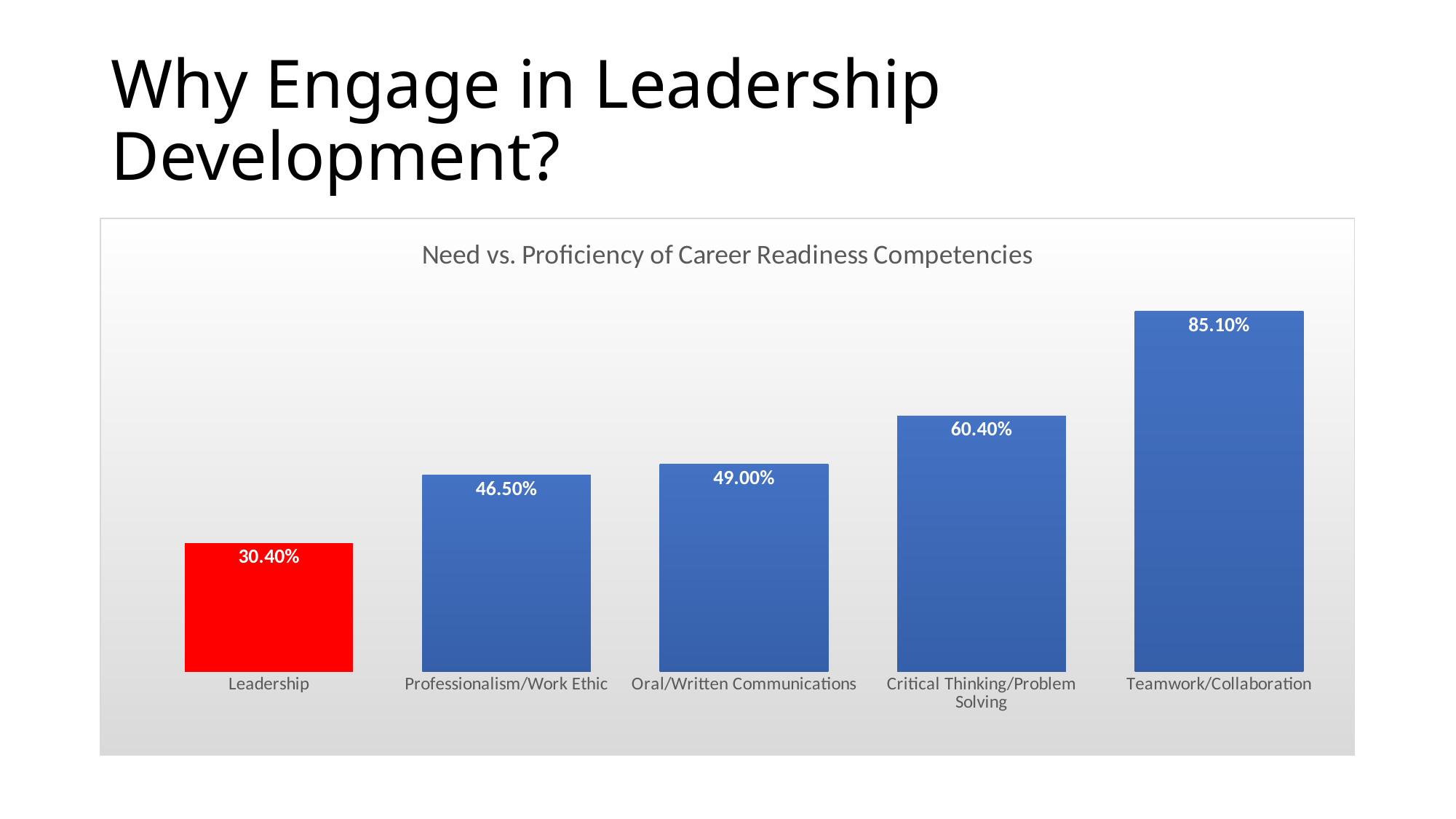
What is the value for Teamwork/Collaboration? 85.10% What is the difference between the values for Teamwork/Collaboration and Leadership? 54.70% Which is larger, the value for Critical Thinking/Problem Solving or the value for Professionalism/Work Ethic? Critical Thinking/Problem Solving What is the title of the chart? Need vs. Proficiency of Career Readiness Competencies Which category has the lowest value? Leadership What is the value for Critical Thinking/Problem Solving? 60.40% What is the value for Oral/Written Communications? 49.00% Which category has the highest value? Teamwork/Collaboration What is the value for Leadership? 30.40% What is the difference between the values for Oral/Written Communications and Professionalism/Work Ethic? 2.50% What kind of chart is shown on the slide? Bar chart How many categories are shown in the chart? 5